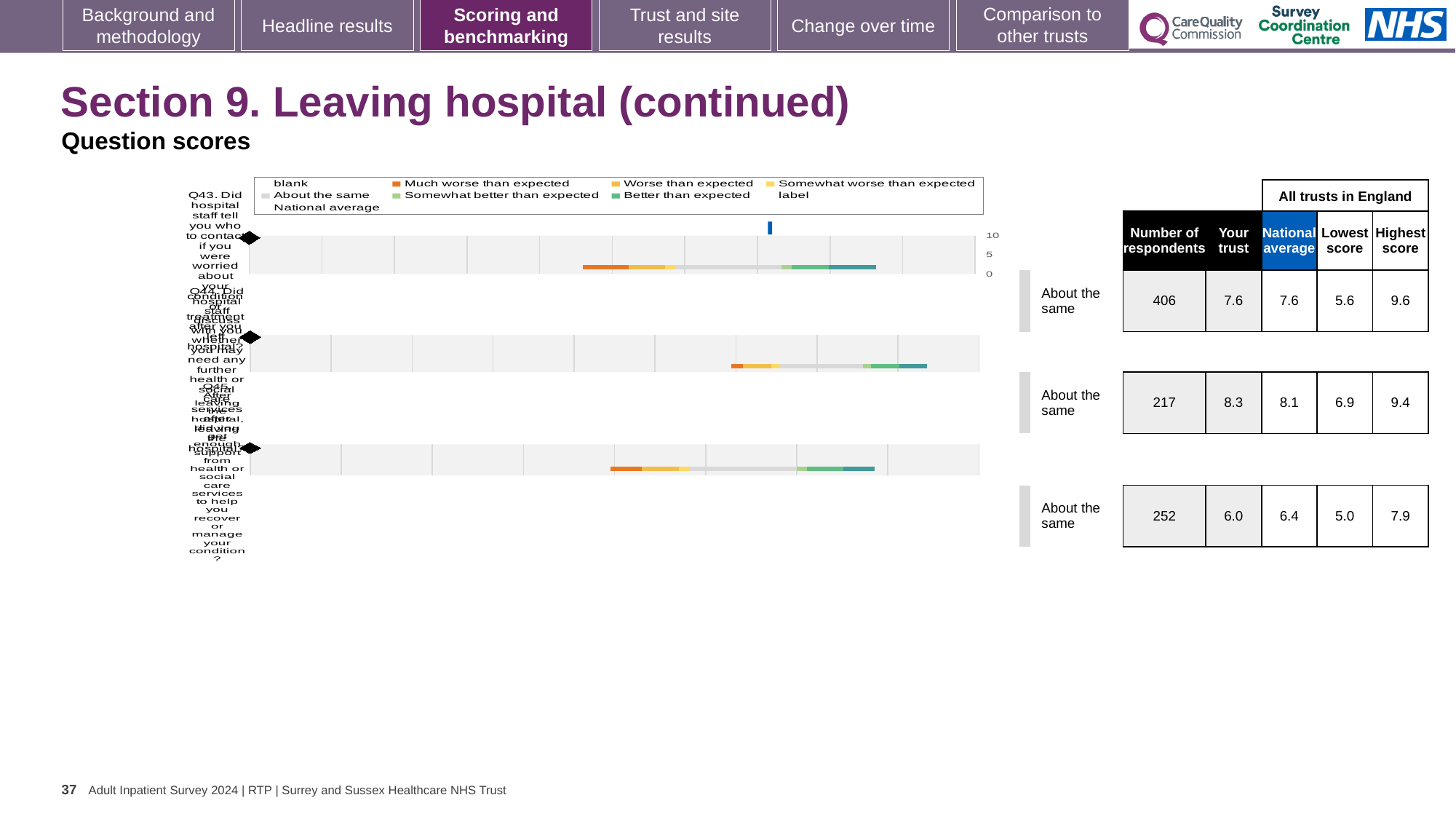
What benchmark category is shown next to each of the three question rows? About the same According to the table beside the chart, what is the 'Your trust' score for the third row (Q45)? 6.0 What is the highest value shown on the chart's score axis? 10 How many question rows are plotted in the chart? 3 According to the table beside the chart, how many respondents answered the first row (Q43)? 406 Which question row has the highest 'Your trust' score in the table? Q44 What kind of chart is shown on the slide? bar chart Which question row has the lowest number of respondents in the table? Q44 For the third row (Q45), what is the difference between the highest score and the lowest score in the table? 2.9 According to the table beside the chart, what is the national average for the second row (Q44)? 8.1 For the second row (Q44), which is larger: the 'Your trust' score or the national average? Your trust According to the table beside the chart, what is the 'Your trust' score for the first row (Q43)? 7.6